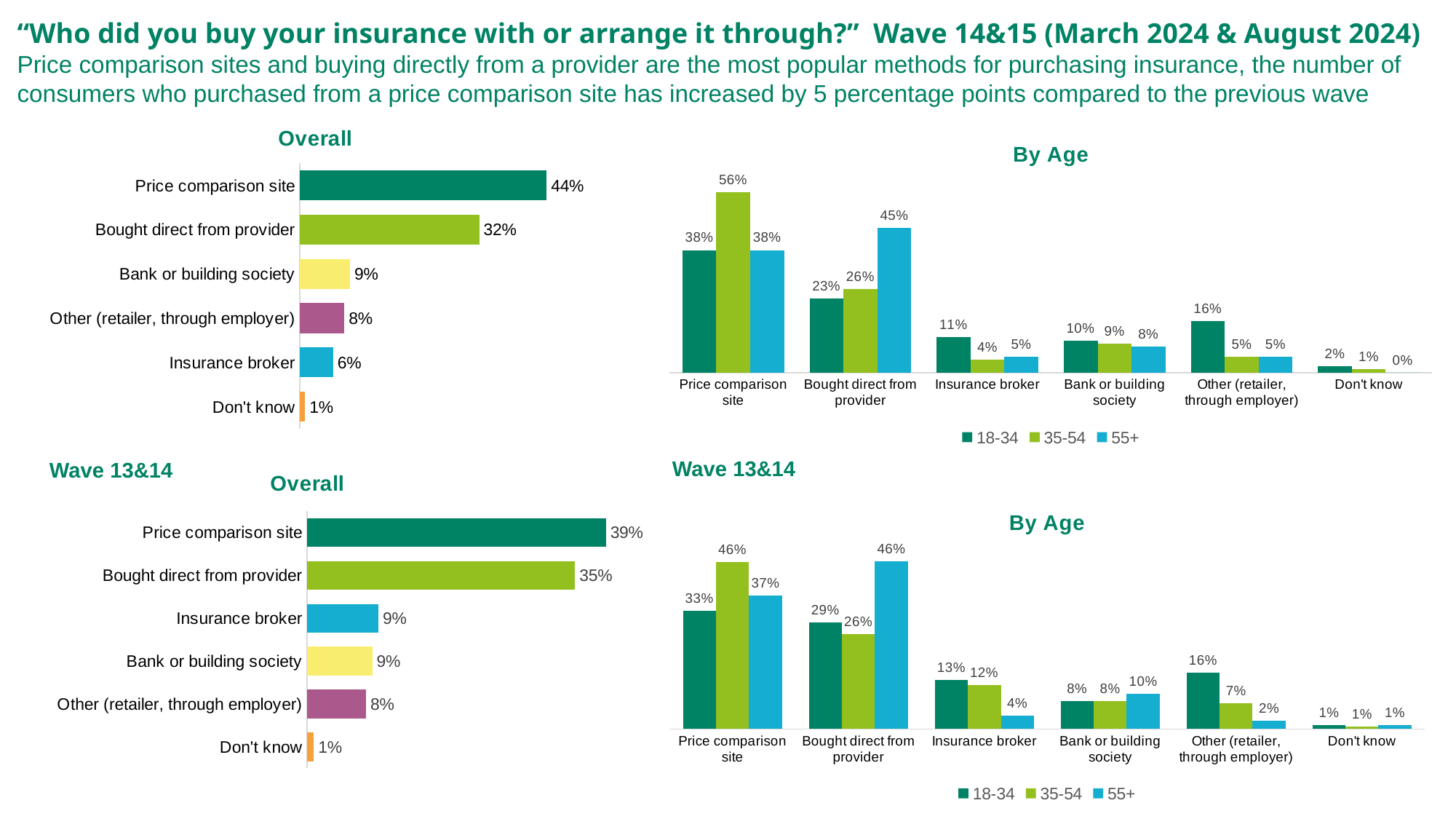
In the top-left 'Overall' chart (Wave 14&15), which category has the lowest value? Don't know In the bottom-left 'Overall' chart (Wave 13&14), what is the value for Bought direct from provider? 35% What type of chart is the top-left 'Overall' chart (Wave 14&15)? Bar chart In the bottom-right 'By Age' chart (Wave 13&14), what is the difference between the 18-34 and 35-54 values for Other (retailer, through employer)? 9 percentage points In the top-left 'Overall' chart (Wave 14&15), what is the value for Price comparison site? 44% In the bottom-left 'Overall' chart (Wave 13&14), which is larger: Price comparison site or Bought direct from provider? Price comparison site In the top-left 'Overall' chart (Wave 14&15), what is the difference between Price comparison site and Bought direct from provider? 12 percentage points How many categories are shown in the top-left 'Overall' chart (Wave 14&15)? 6 In the top-right 'By Age' chart (Wave 14&15), which age group has the highest value for Bought direct from provider? 55+ How many series does the legend list in the top-right 'By Age' chart (Wave 14&15)? 3 In the bottom-right 'By Age' chart (Wave 13&14), what is the value for the 55+ group for Insurance broker? 4% In the top-right 'By Age' chart (Wave 14&15), what is the value for the 35-54 group for Price comparison site? 56%